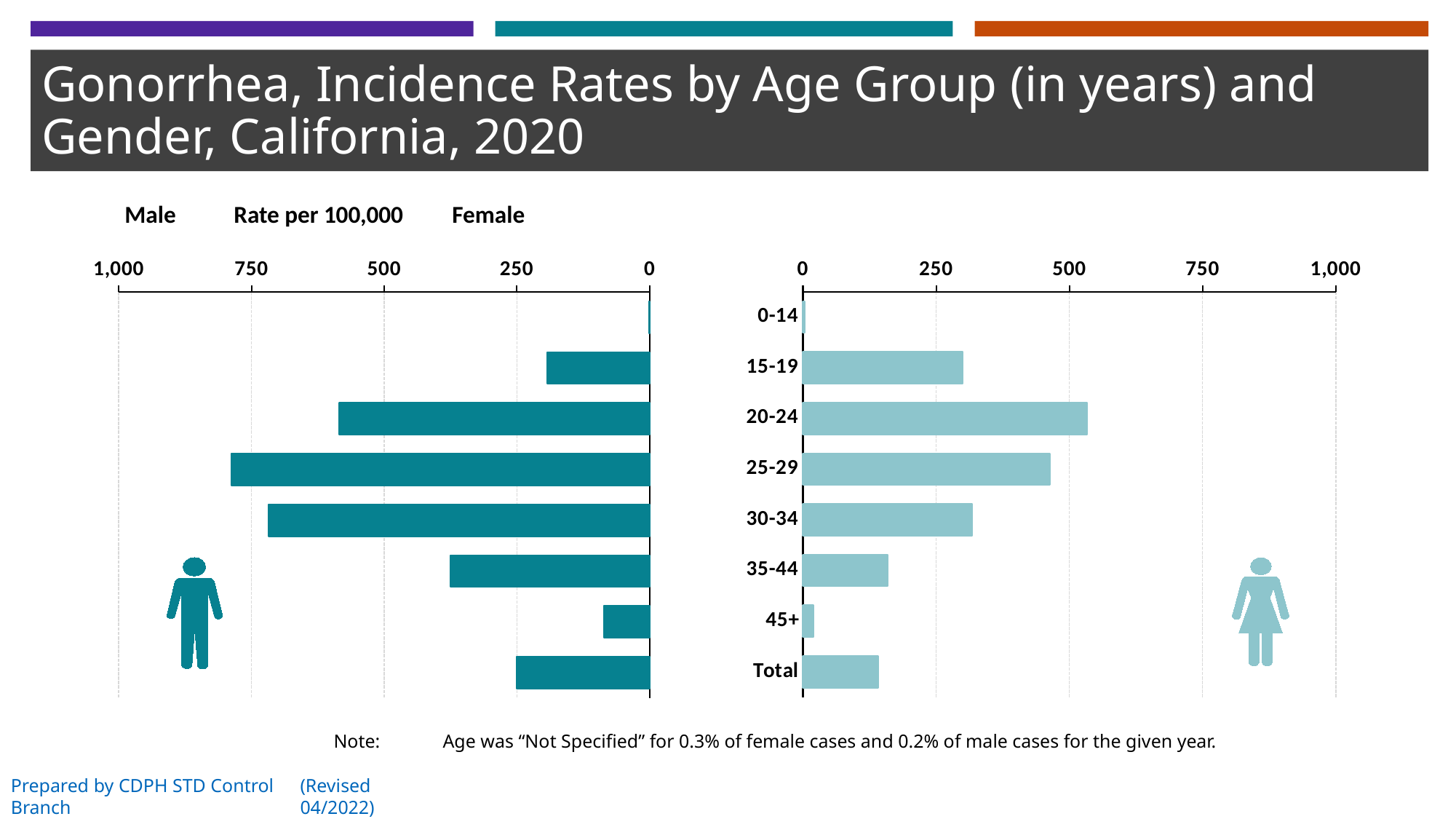
For the 45+ age group, is the male or the female rate higher? Male What unit is the rate measured in, according to the label above the chart? Rate per 100,000 For the 15-19 age group, is the male or the female rate higher? Female Is the female rate for the 35-44 age group greater or less than 250? less What kind of chart is shown on the slide? bar chart Is the female rate for the 25-29 age group greater or less than 500? less Is the male rate for the 25-29 age group greater or less than 750? greater Which age group has the lowest male gonorrhea incidence rate? 0-14 Which age group has the highest male gonorrhea incidence rate? 25-29 Which age group has the highest female gonorrhea incidence rate? 20-24 Which age group has the lowest female gonorrhea incidence rate? 0-14